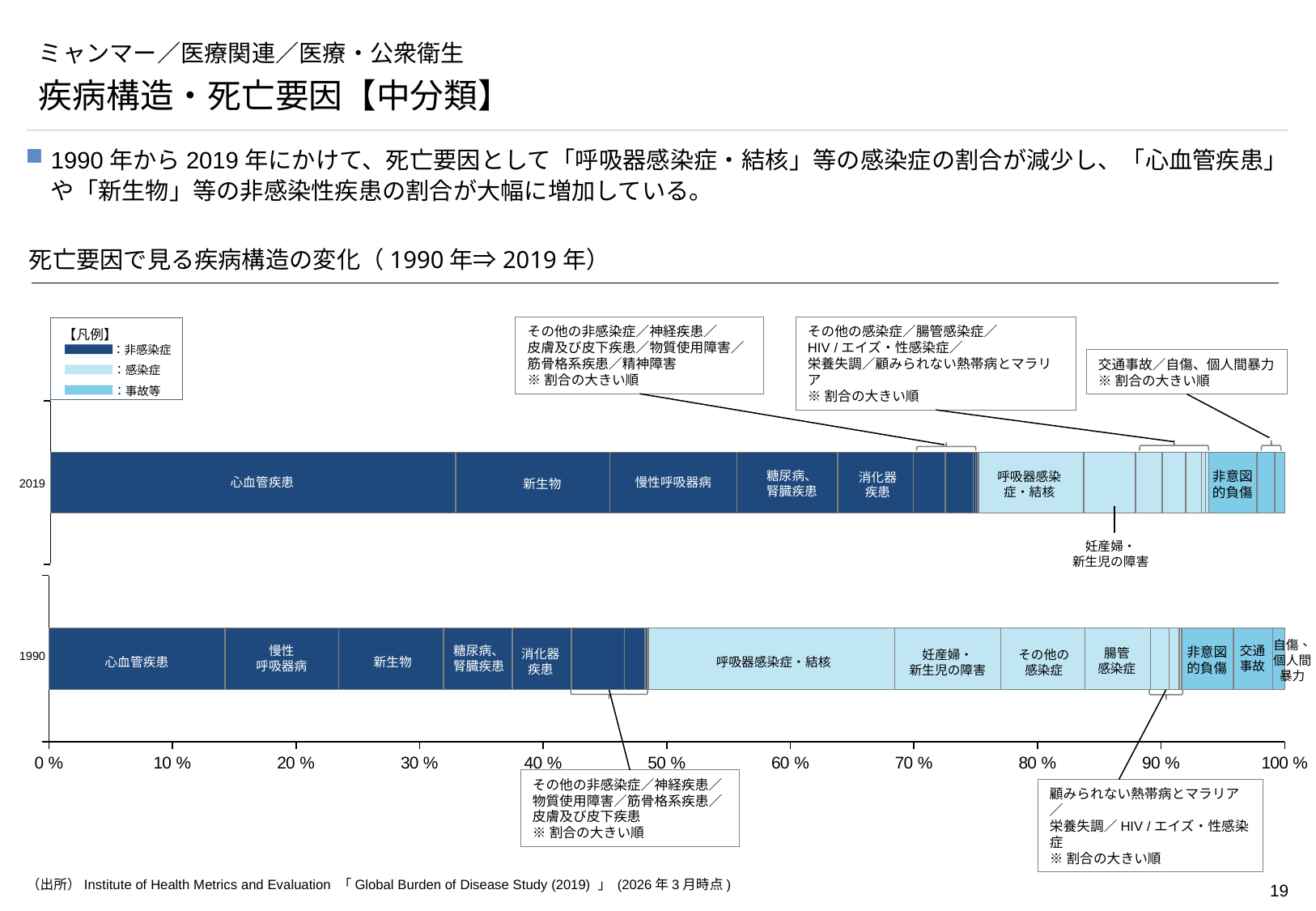
What is the title of the chart? 死亡要因で見る疾病構造の変化（1990年⇒2019年） Which cause of death has the largest share in the 2019 bar? 心血管疾患 Which cause of death has the largest share in the 1990 bar? 呼吸器感染症・結核 What kind of chart is shown on the slide? Stacked horizontal bar chart Is the share of 呼吸器感染症・結核 in 1990 greater or less than 10%? greater Which year has the larger share of 呼吸器感染症・結核, 1990 or 2019? 1990 Which year has the larger share of 心血管疾患, 1990 or 2019? 2019 How many years (bars) does the chart compare? 2 Is the share of 心血管疾患 in 2019 greater or less than 30%? greater Is the share of 心血管疾患 in 1990 greater or less than 20%? less In the 2019 bar, which has the larger share, 新生物 or 糖尿病、腎臓疾患? 新生物 How many categories does the legend (凡例) list? 3